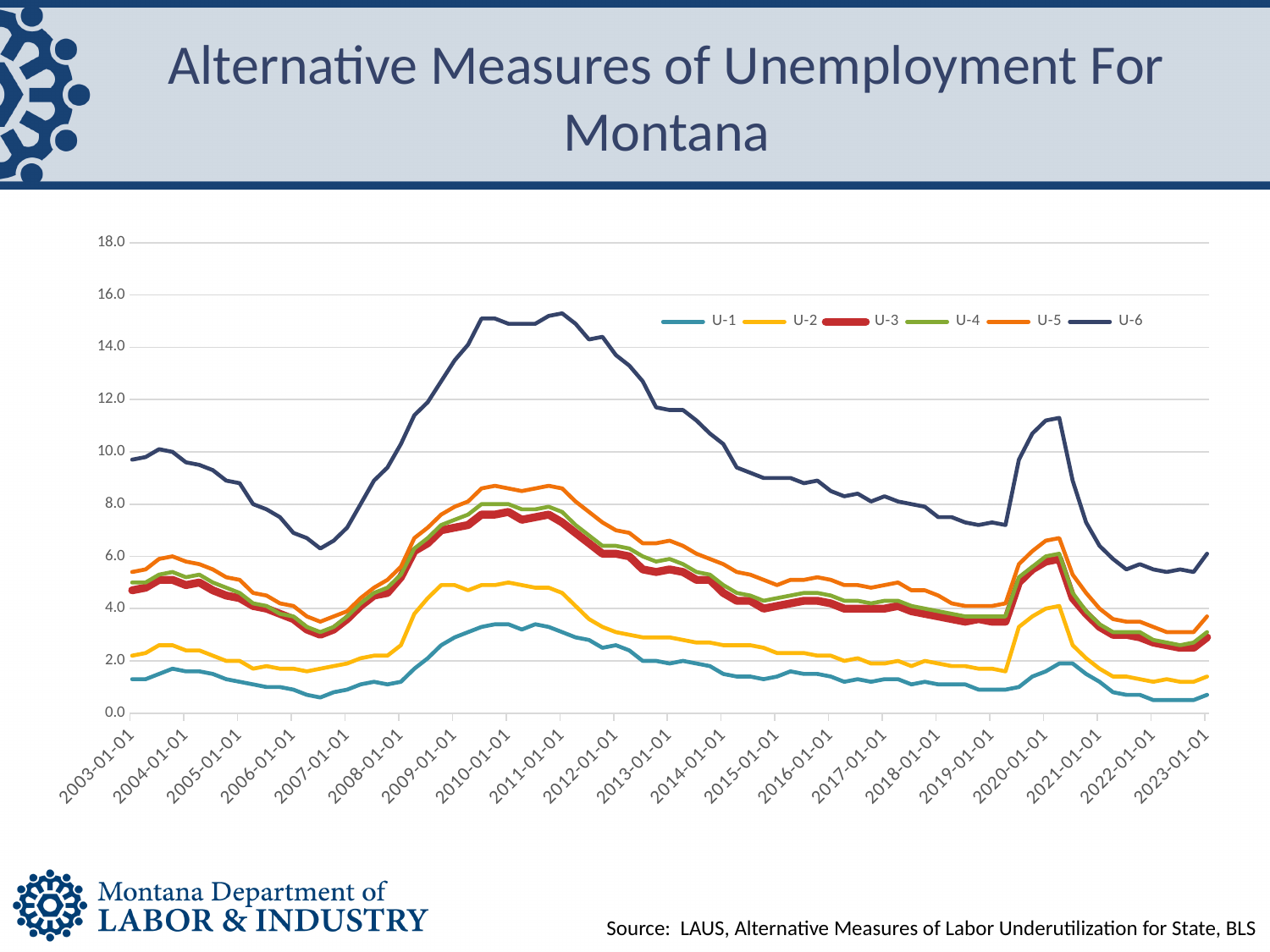
What kind of chart is shown on the slide? line chart Which series has the lowest values across the chart? U-1 Is the value for U-6 at 2010-01-01 greater or less than 12.0? greater Is the value for U-1 at 2007-01-01 greater or less than 2.0? less Is the peak value for U-6 around 2020 greater or less than 10.0? greater How many year labels are shown along the x axis? 21 What is the title of the chart on the slide? Alternative Measures of Unemployment For Montana Does the U-6 series rise or fall between 2011-01-01 and 2019-01-01? fall Which series has the highest values across the chart? U-6 Which is larger at 2010-01-01, U-6 or U-1? U-6 How many series does the legend list? 6